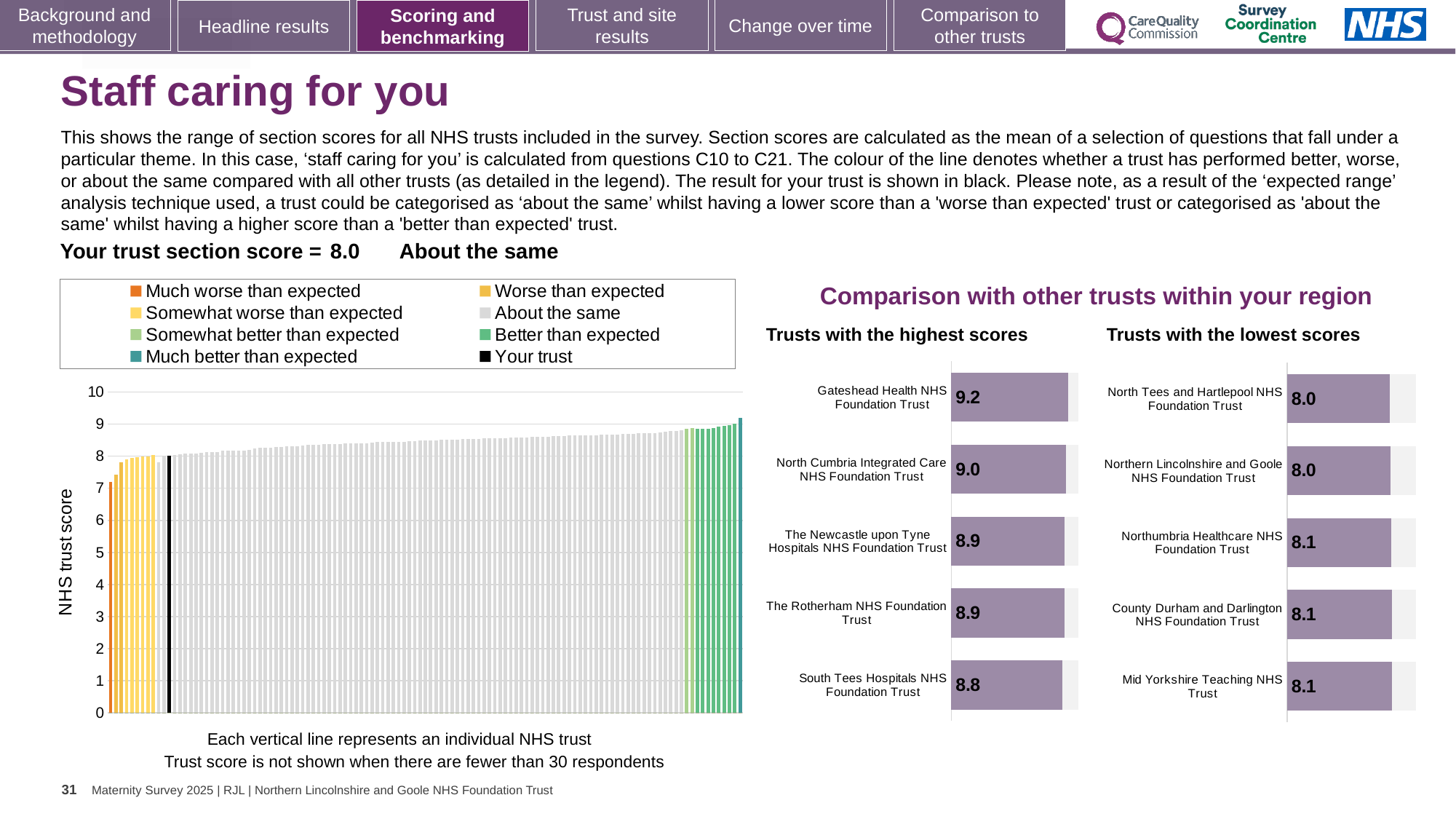
In the 'Trusts with the lowest scores' chart, which has the higher score: North Tees and Hartlepool NHS Foundation Trust or Mid Yorkshire Teaching NHS Trust? Mid Yorkshire Teaching NHS Trust In the left-hand chart, do the trust scores rise or fall from left to right? rise In the 'Trusts with the highest scores' chart, which trust has the highest score? Gateshead Health NHS Foundation Trust In the 'Trusts with the lowest scores' chart, what is the score for North Tees and Hartlepool NHS Foundation Trust? 8.0 In the 'Trusts with the highest scores' chart, how many trusts are shown? 5 What kind of chart is the large chart on the left showing NHS trust scores? bar chart In the 'Trusts with the highest scores' chart, what is the difference between the scores of Gateshead Health NHS Foundation Trust and South Tees Hospitals NHS Foundation Trust? 0.4 In the left-hand chart, is the value of the black bar for your trust greater or less than 5? greater In the 'Trusts with the lowest scores' chart, what is the score for Northumbria Healthcare NHS Foundation Trust? 8.1 How many entries does the legend above the left-hand chart list? 8 In the 'Trusts with the highest scores' chart, what is the score for Gateshead Health NHS Foundation Trust? 9.2 In the 'Trusts with the lowest scores' chart, how many trusts are shown? 5